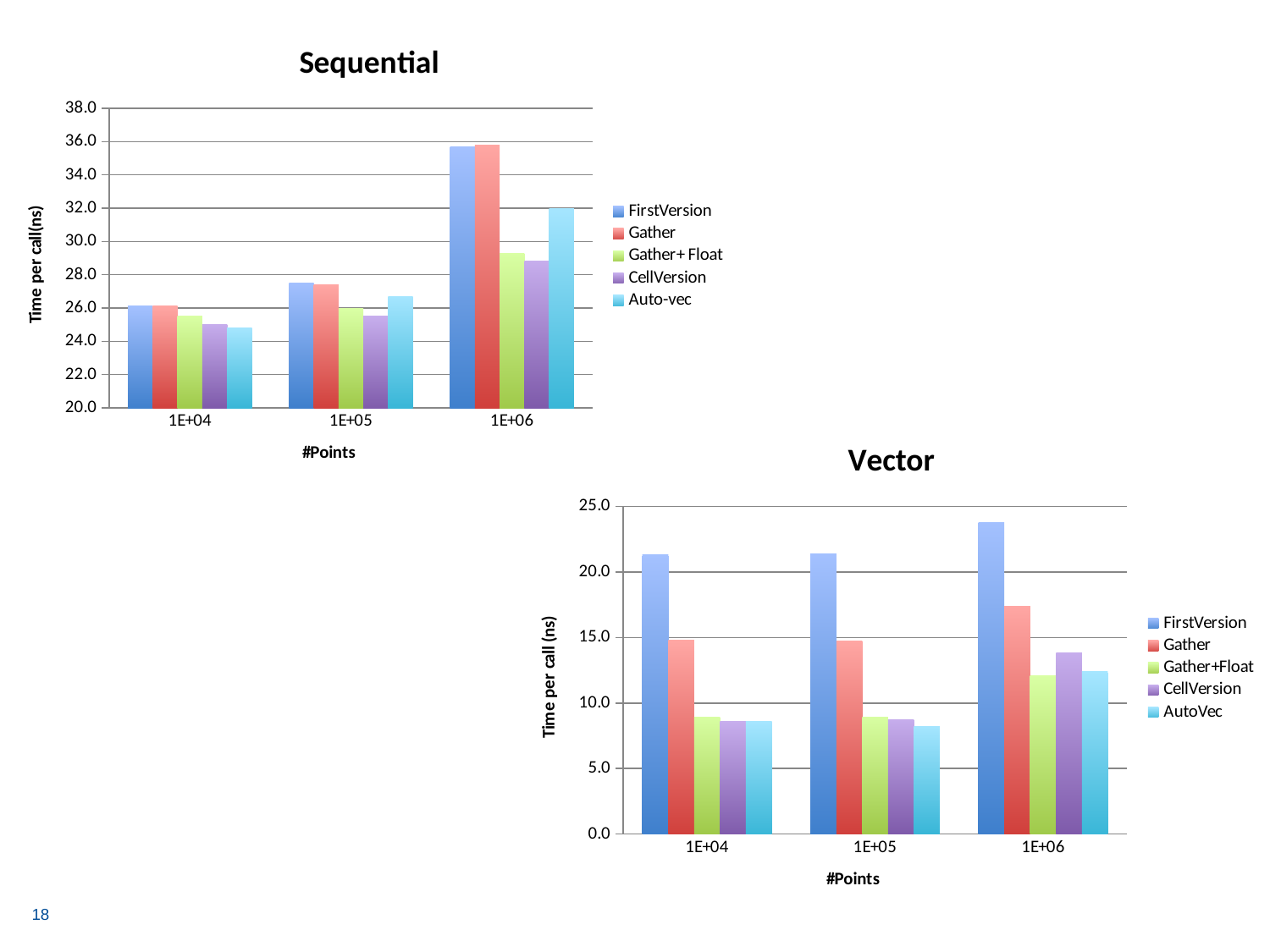
In the Vector chart, which series has the highest bar at 1E+06? FirstVersion In the Sequential chart, at which #Points category is the FirstVersion bar highest? 1E+06 What is the y-axis label of the Vector chart? Time per call (ns) In the Sequential chart, is the value for Auto-vec at 1E+06 greater or less than 30.0? greater In the Sequential chart, is the value for CellVersion at 1E+06 greater or less than 30.0? less In the Vector chart, is the value for FirstVersion at 1E+04 greater or less than 20.0? greater What kind of chart is the Sequential chart? bar chart In the Sequential chart, do the FirstVersion values rise or fall as #Points increases along the x axis? rise How many #Points categories are shown on the x axis of the Sequential chart? 3 In the Vector chart, at 1E+04, which is larger: Gather or Gather+Float? Gather How many series does the legend of the Sequential chart list? 5 How many series does the legend of the Vector chart list? 5